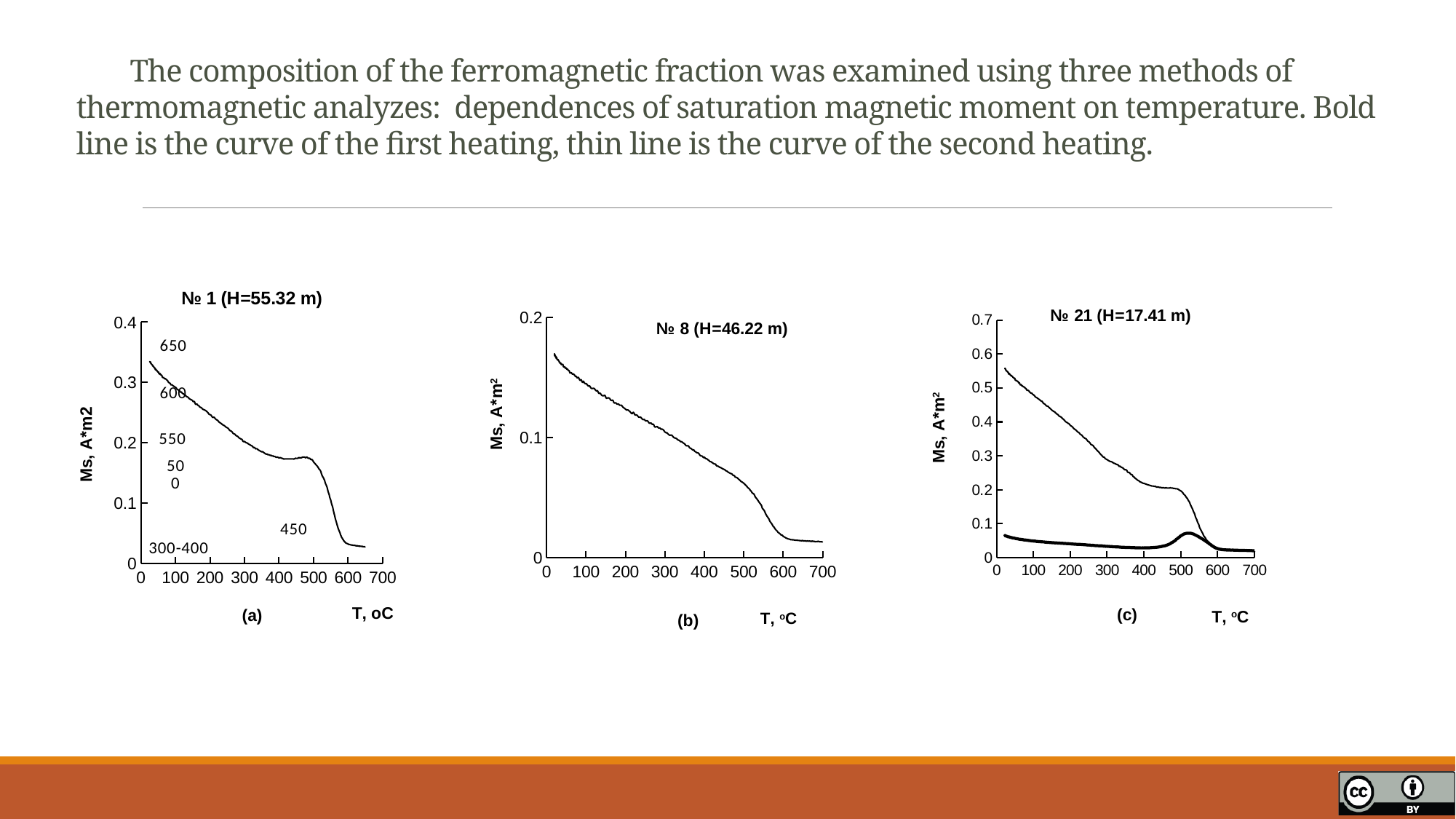
What is the highest tick value on the y axis of the chart titled "№ 21 (H=17.41 m)"? 0.7 How many charts are shown on the slide? 3 In the chart titled "№ 1 (H=55.32 m)", is the value of Ms at T = 100 greater or less than 0.2? greater In the chart titled "№ 21 (H=17.41 m)", which line is higher at T = 200, the thin line or the bold line? thin line In the chart titled "№ 8 (H=46.22 m)", is the value of Ms at T = 650 greater or less than 0.1? less In the chart titled "№ 8 (H=46.22 m)", is the value of Ms at T = 100 greater or less than 0.1? greater What kind of chart is the chart titled "№ 1 (H=55.32 m)"? line chart What is the title of the rightmost chart, labelled (c)? № 21 (H=17.41 m) In the chart titled "№ 8 (H=46.22 m)", does the saturation magnetic moment rise or fall overall as temperature increases from 0 to 700? fall